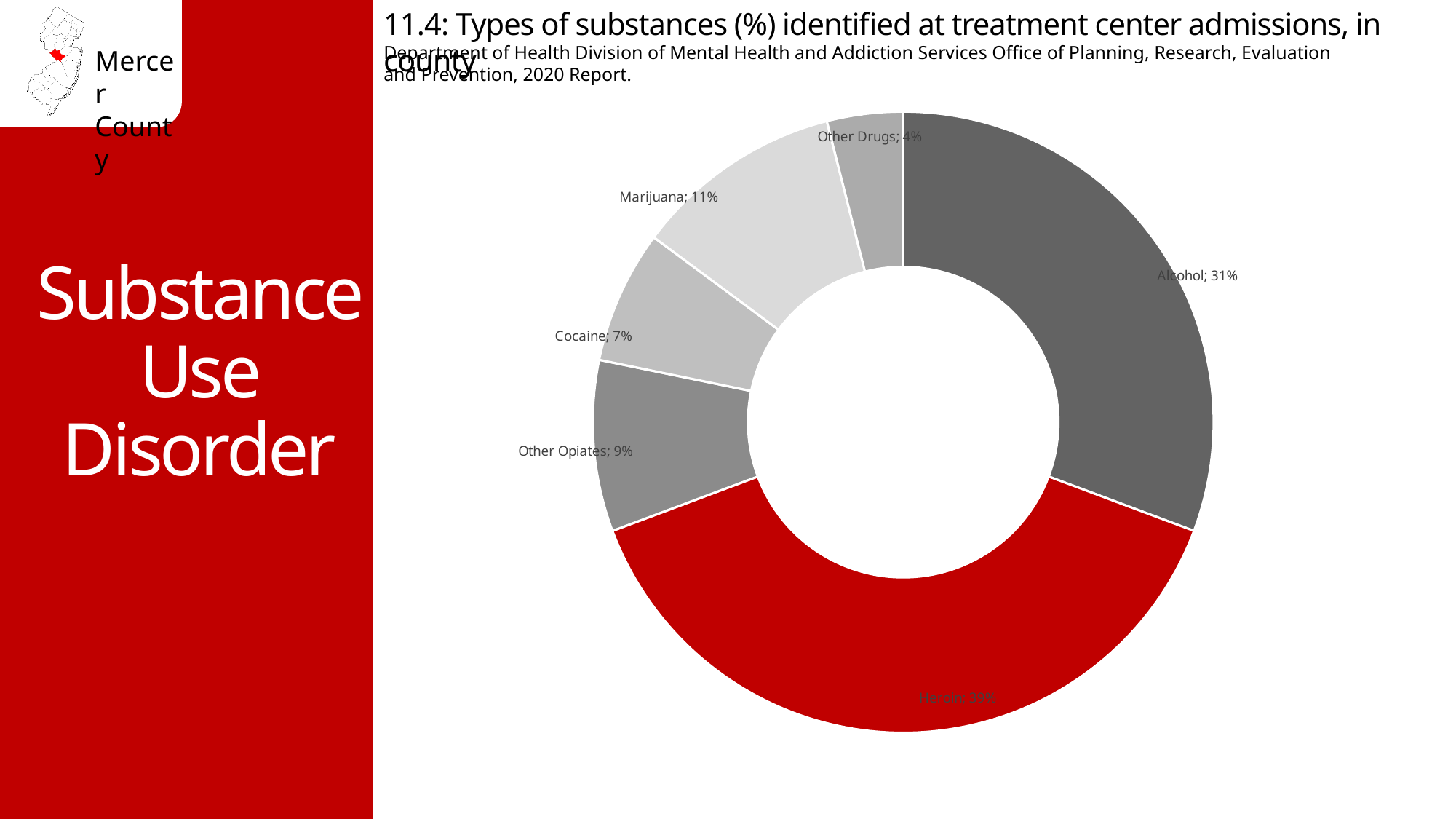
What is the difference in percentage points between Marijuana and Cocaine? 4 What type of chart is used on this slide? Doughnut (pie) chart Which has a larger share, Alcohol or Other Opiates? Alcohol What percentage is shown for Cocaine? 7% What percentage is shown for Other Drugs? 4% Which substance has the smallest share of admissions? Other Drugs How many substance categories are shown in the chart? 6 What percentage is shown for Marijuana? 11% What percentage is shown for Other Opiates? 9% Which substance has the largest share of admissions? Heroin What percentage of treatment center admissions is attributed to Alcohol? 31% Which slice of the chart is coloured red? Heroin